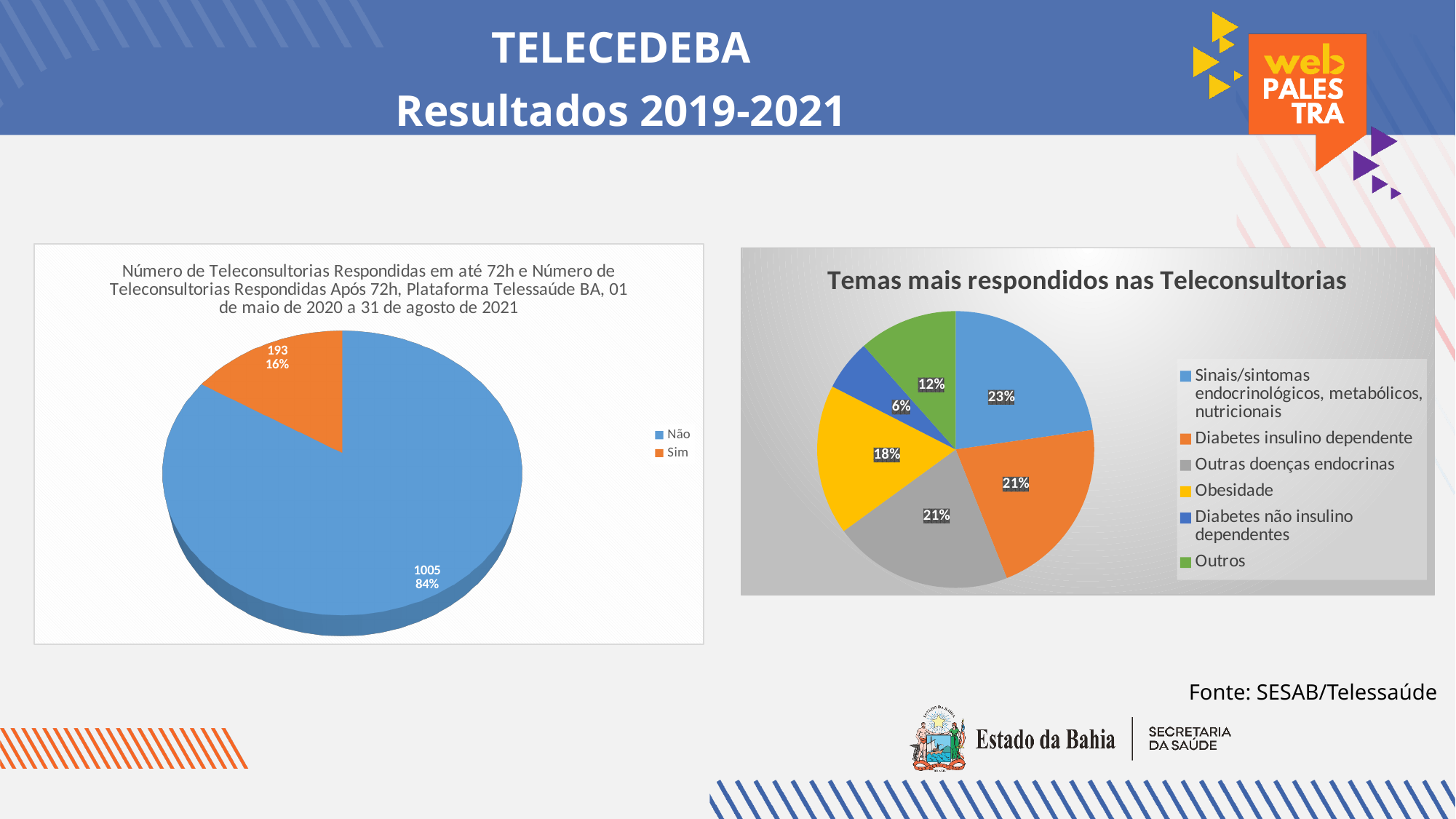
In the left pie chart, what is the value for "Sim"? 193 In the left pie chart, what is the difference between the values for "Não" and "Sim"? 812 In the chart "Temas mais respondidos nas Teleconsultorias", what share does "Diabetes não insulino dependentes" have? 6% In the left pie chart, what is the value for "Não"? 1005 How many categories does the legend of the chart "Temas mais respondidos nas Teleconsultorias" list? 6 In the left pie chart, what share of the pie does "Sim" represent? 16% In the left pie chart, which category is larger, "Não" or "Sim"? Não In the chart "Temas mais respondidos nas Teleconsultorias", what share does "Obesidade" have? 18% In the chart "Temas mais respondidos nas Teleconsultorias", which category has the largest share? Sinais/sintomas endocrinológicos, metabólicos, nutricionais In the chart "Temas mais respondidos nas Teleconsultorias", what colour is the "Outros" slice? Green What kind of chart is the chart titled "Temas mais respondidos nas Teleconsultorias"? Pie chart In the chart "Temas mais respondidos nas Teleconsultorias", which category has the smallest share? Diabetes não insulino dependentes